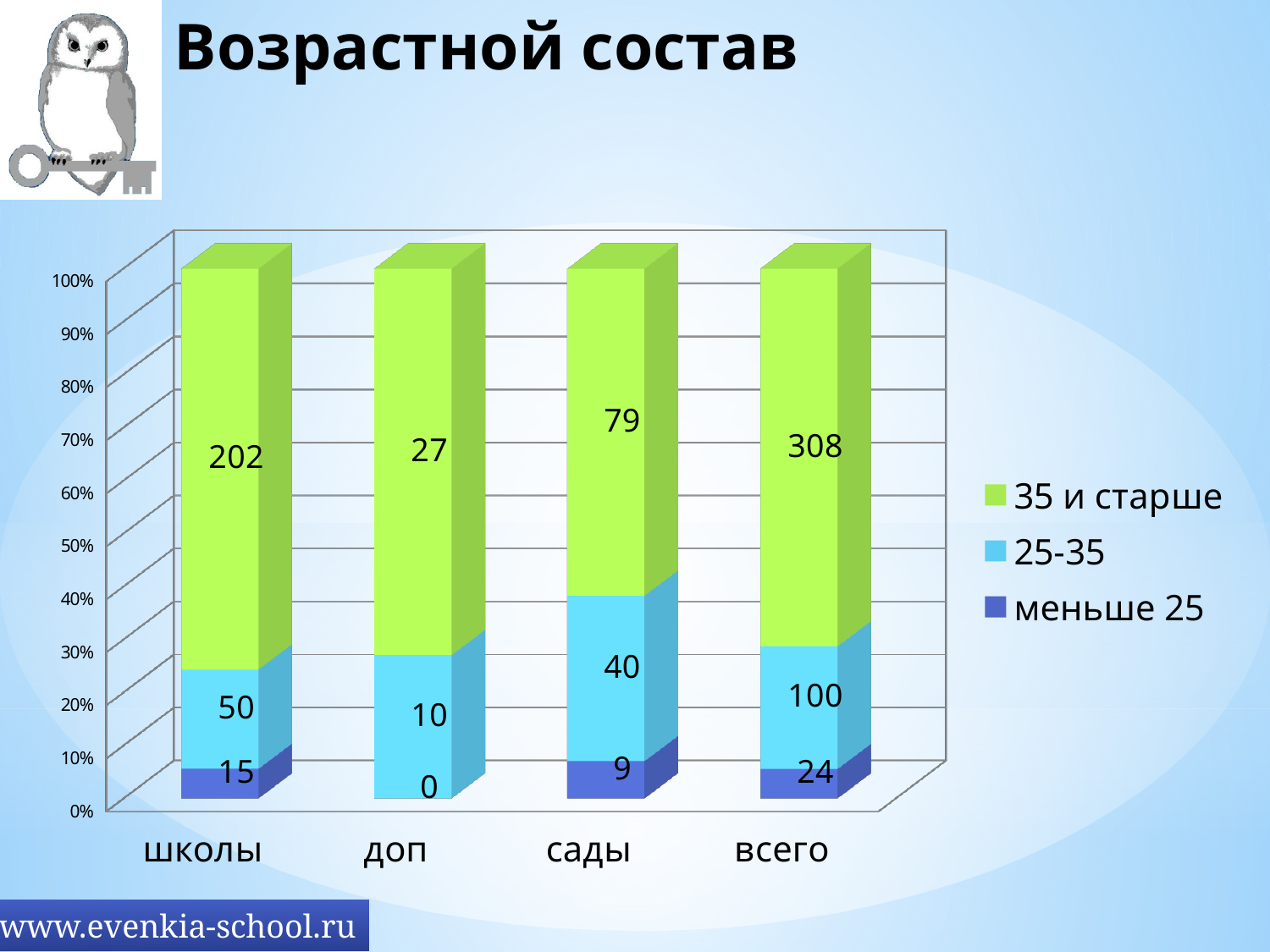
What kind of chart is shown on the slide? stacked bar chart How many categories are shown on the x axis? 4 What is the total of the three values in the 'сады' bar? 128 Which category has the highest value for '35 и старше'? всего How many series does the legend list? 3 Which is larger: the '25-35' value for 'школы' or for 'сады'? школы What is the difference between the '35 и старше' values for 'школы' and 'сады'? 123 Which category has the lowest value for 'меньше 25'? доп What is the value for '25-35' in the 'всего' category? 100 What is the value for 'меньше 25' in the 'доп' category? 0 What is the value for '25-35' in the 'сады' category? 40 What is the value for '35 и старше' in the 'школы' category? 202